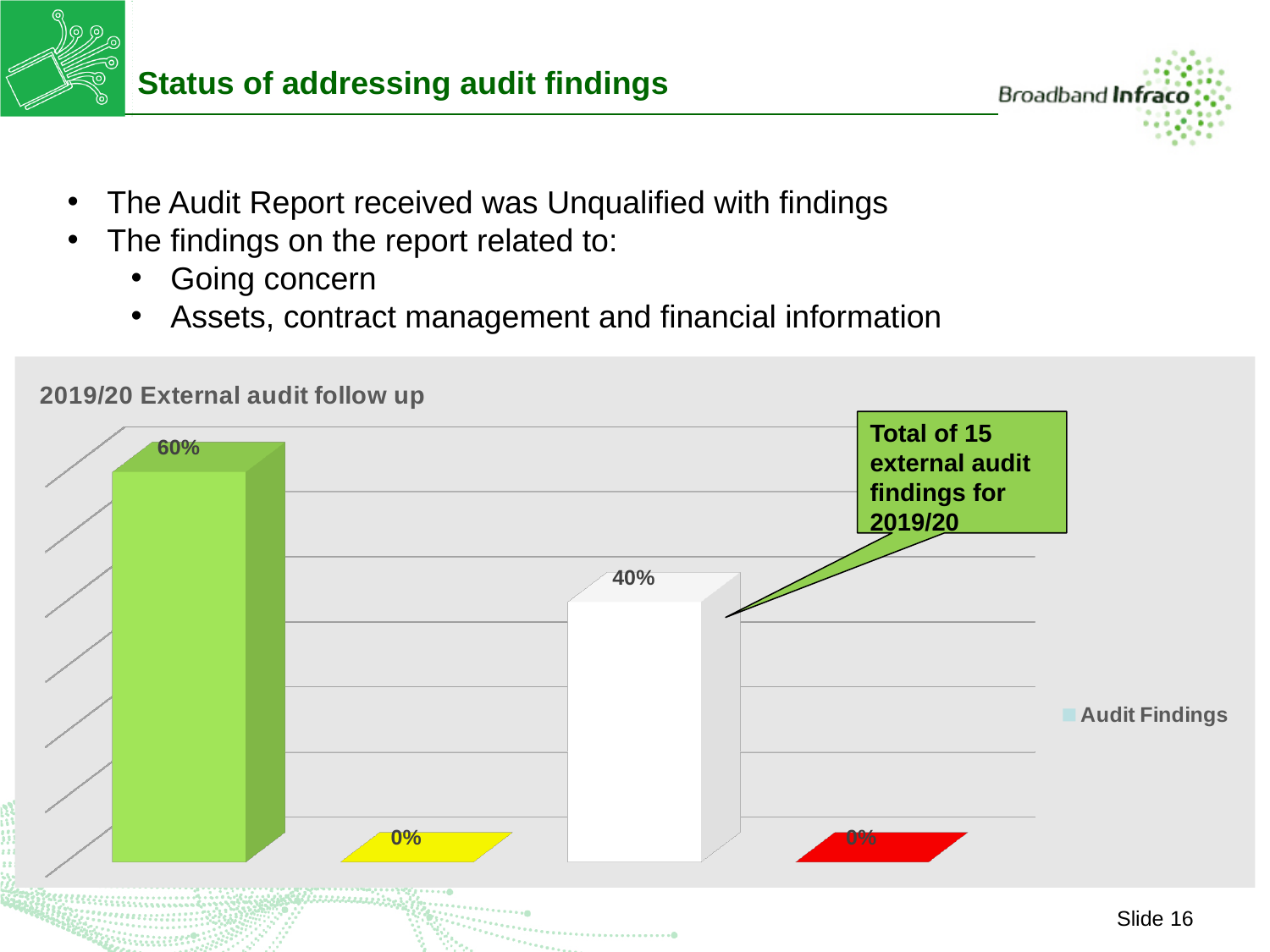
Which is larger, the value of the green bar or the value of the white bar? the green bar What value is labelled on the red bar (the fourth bar from the left)? 0% What is the name of the series shown in the chart legend? Audit Findings What value is labelled on the green bar (the first bar from the left)? 60% How many series does the chart legend list? 1 What type of chart is shown on the slide? bar chart What value is labelled on the yellow bar (the second bar from the left)? 0% What is the title of the chart on the slide? 2019/20 External audit follow up What value is labelled on the white bar (the third bar from the left)? 40% How many bars are plotted in the chart? 4 Which bar has the highest value in the chart? the green bar (60%) What is the difference between the green bar's value and the white bar's value? 20%